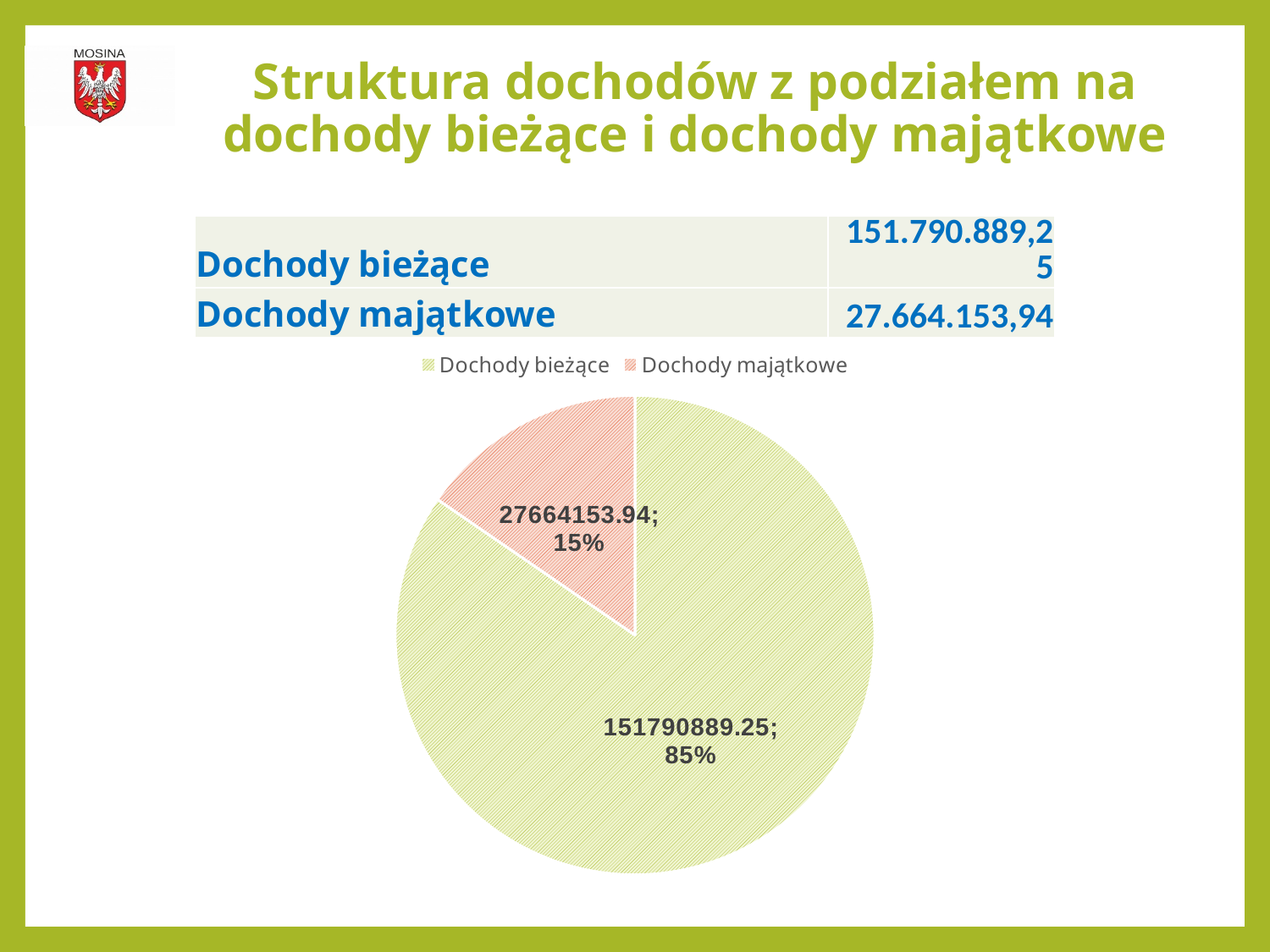
How many entries does the legend list? 2 What share of the pie does Dochody bieżące represent? 85% Which category has the smallest slice of the pie? Dochody majątkowe How many slices does the pie chart have? 2 What kind of chart is shown on the slide? pie chart What colour is the Dochody majątkowe slice in the pie chart? red/pink Which category has the largest slice of the pie? Dochody bieżące What is the difference in percentage points between the Dochody bieżące share and the Dochody majątkowe share? 70 percentage points What value is labelled on the pie slice for Dochody majątkowe? 27664153.94 Which is larger, Dochody bieżące or Dochody majątkowe? Dochody bieżące What value is labelled on the pie slice for Dochody bieżące? 151790889.25 What share of the pie does Dochody majątkowe represent? 15%